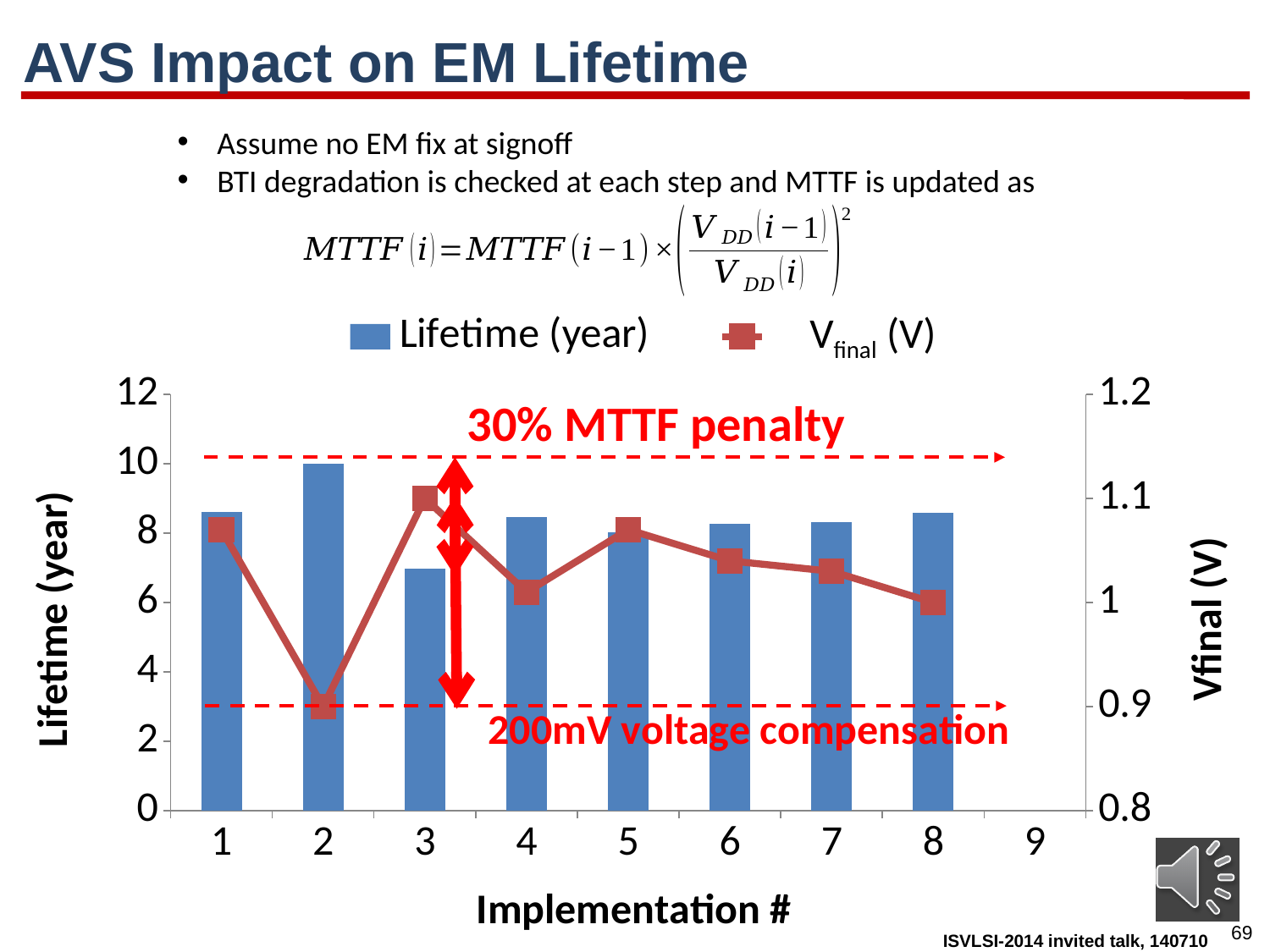
Is the Lifetime (year) for implementation 3 greater or less than 8? less Which has the larger Lifetime (year): implementation 2 or implementation 3? Implementation 2 What type of chart is shown on the slide? Combined bar and line chart How many implementations have a Lifetime bar plotted? 8 Which implementation has the highest Lifetime (year)? 2 Which implementation has the lowest Lifetime (year)? 3 How many series does the legend list? 2 What is the title of the right-hand vertical axis? Vfinal (V) Is the Vfinal (V) for implementation 2 greater or less than 1? less Is the Vfinal (V) for implementation 3 greater or less than 1? greater Which implementation has the highest Vfinal (V)? 3 Which implementation has the lowest Vfinal (V)? 2